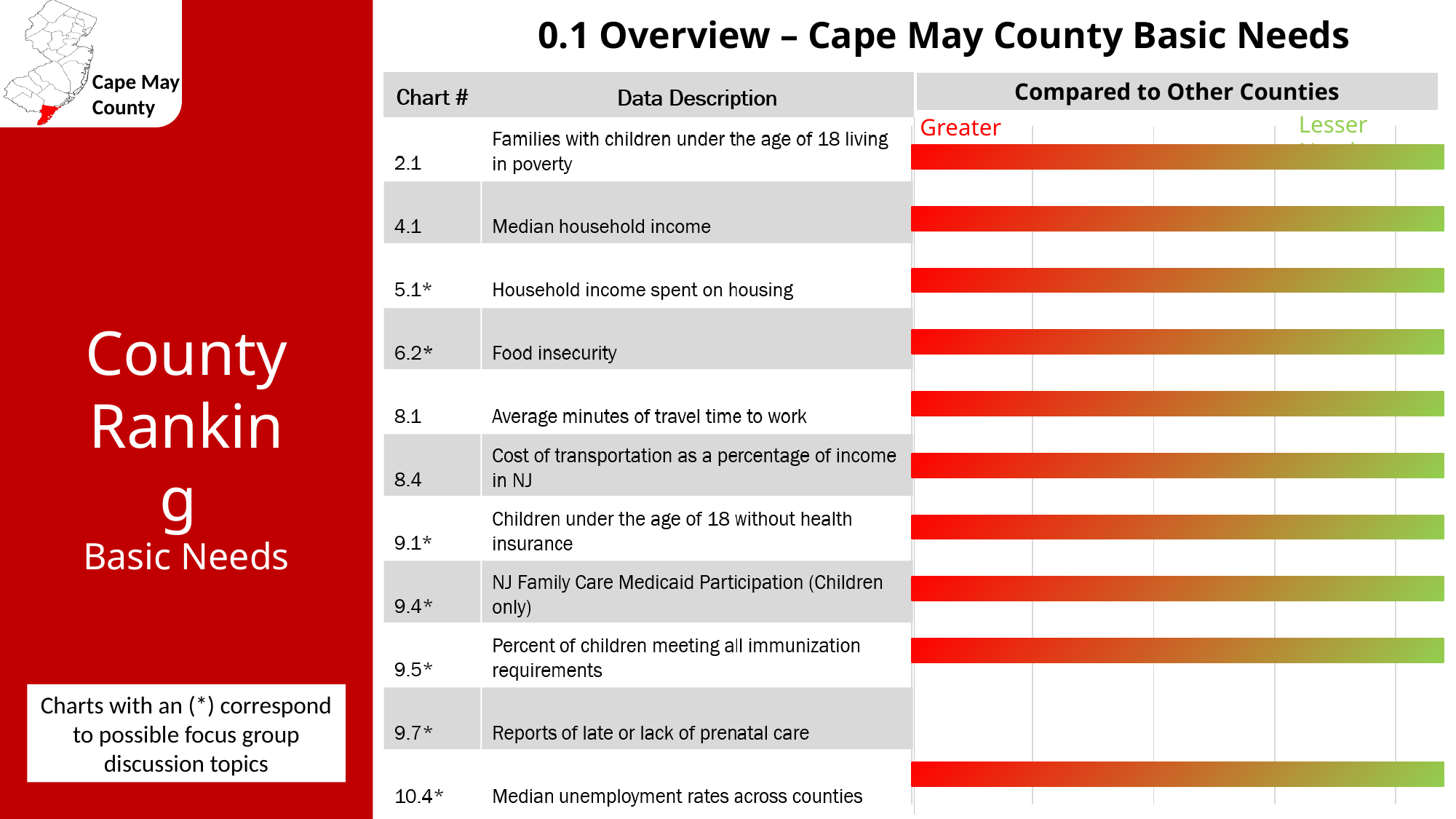
What data description is listed for chart number 10.4*? Median unemployment rates across counties Which chart number corresponds to the row 'Median household income'? 4.1 Which chart number corresponds to the row 'Food insecurity'? 6.2* What kind of chart is used in the 'Compared to Other Counties' column? bar chart How many gradient bars are shown in the 'Compared to Other Counties' column? 11 What label appears at the left (red) end of the 'Compared to Other Counties' scale? Greater How many rows in the table have a chart number marked with an asterisk (*)? 7 What is the heading above the gradient bars on the right side of the slide? Compared to Other Counties